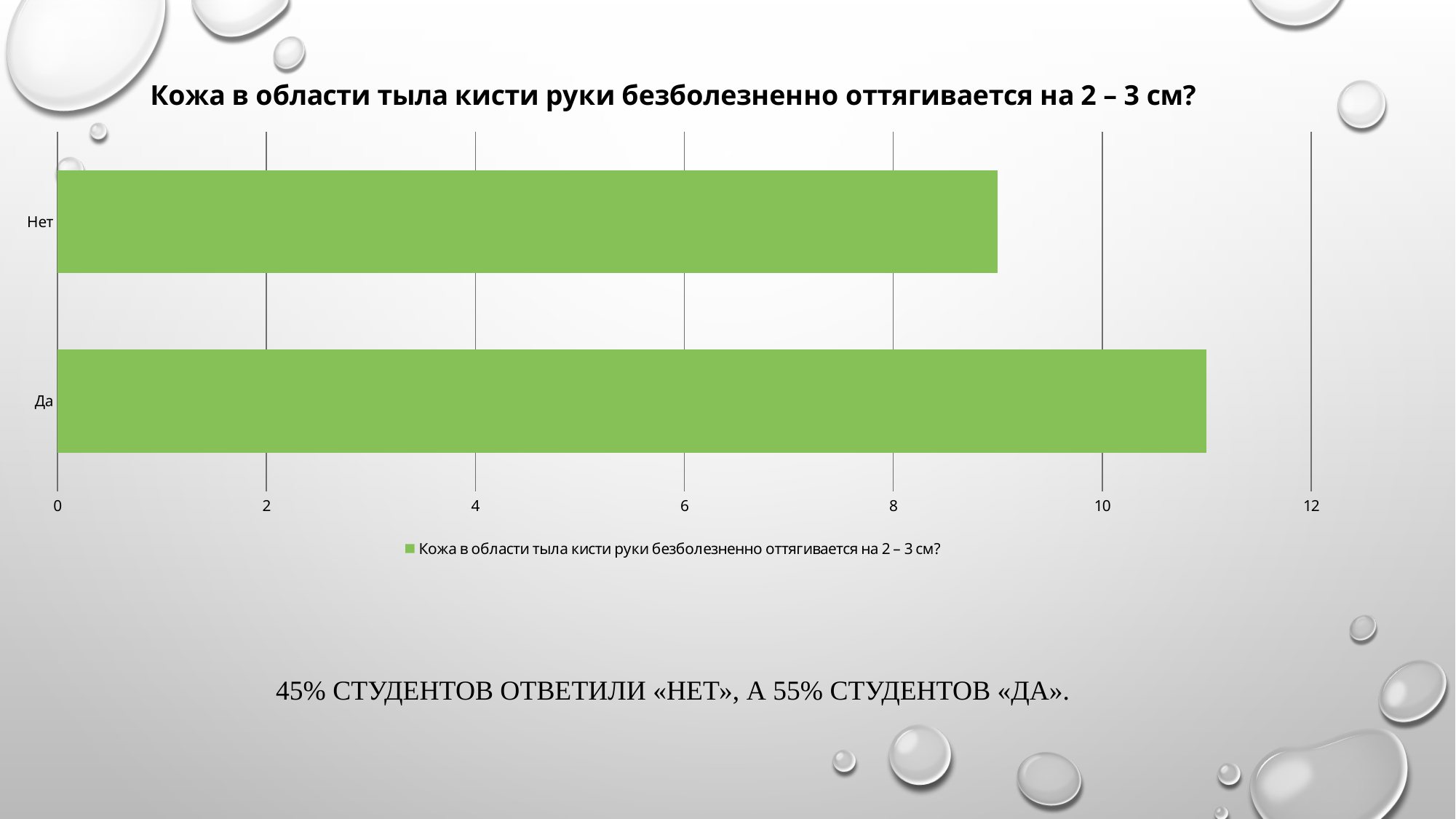
Is the value for Нет greater or less than 8? greater Is the value for Да greater or less than 12? less What kind of chart is shown on the slide? bar chart Which category has the highest value? Да Is the value for Да greater or less than 10? greater What colour are the bars in the chart? green How many series does the legend list? 1 What is the title of the chart? Кожа в области тыла кисти руки безболезненно оттягивается на 2 – 3 см? Which is larger, the value for Да or the value for Нет? Да How many categories does the chart show? 2 Which category has the lowest value? Нет